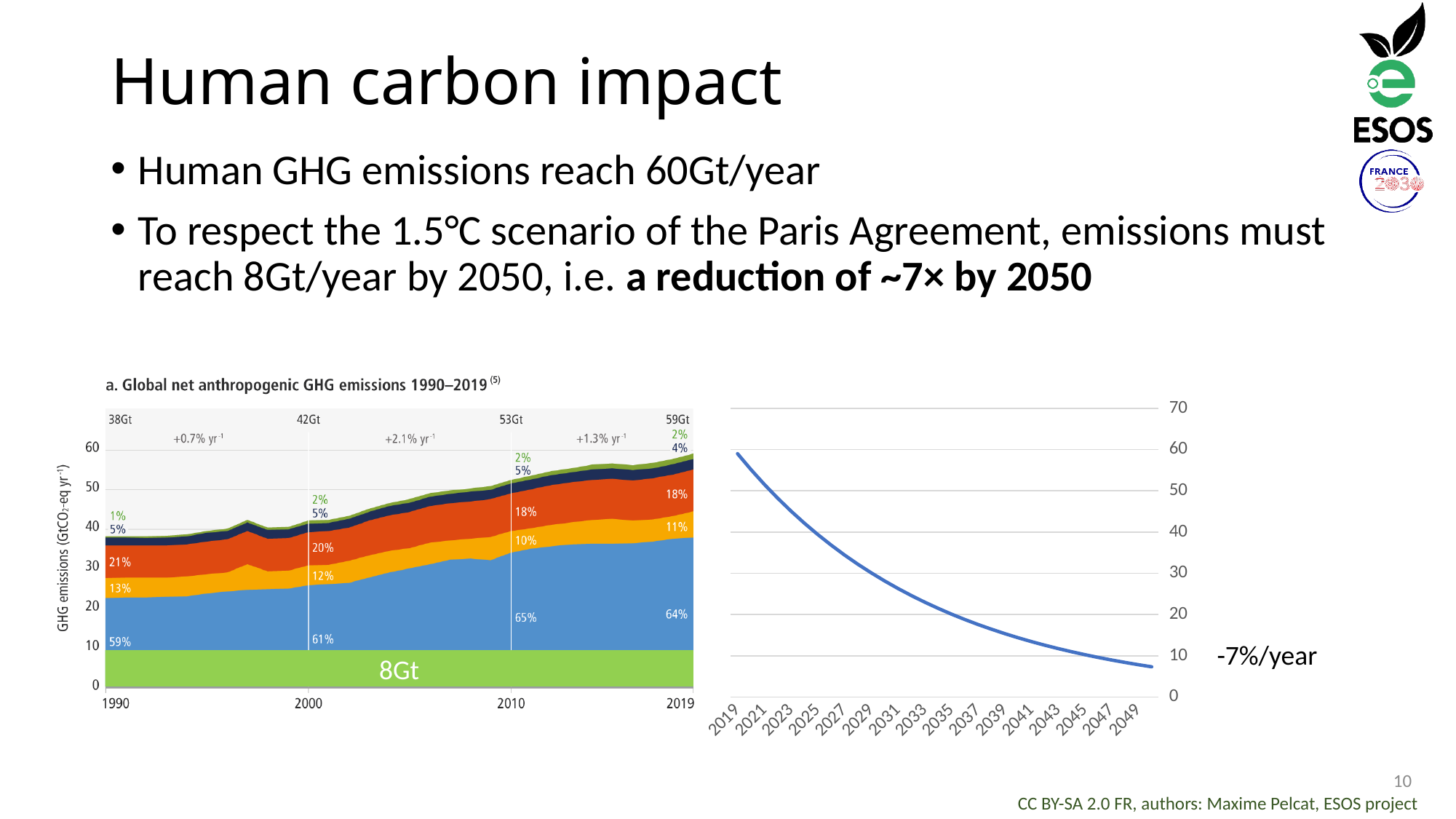
On the left chart, what was the total global net anthropogenic GHG emissions in 2019? 59Gt On the right chart, what annual rate of change is annotated next to the line? -7%/year On the left chart, what emissions level is marked by the green band at the bottom? 8Gt On the right chart, do the values rise or fall from 2019 to 2049? Fall On the left chart, by how much did total GHG emissions increase between 1990 and 2019? 21Gt On the left chart, what was the total global net anthropogenic GHG emissions in 2010? 53Gt On the left chart, what annual growth rate is shown for the period between 2000 and 2010? +2.1% yr⁻¹ On the left chart, what share of emissions did the orange (second from bottom) category represent in 2000? 12% What kind of chart is the chart on the right of the slide? Line chart On the left chart, what was the total global net anthropogenic GHG emissions in 1990? 38Gt On the left chart, which of the four labelled years has the highest total emissions? 2019 On the left chart, what share of emissions did the blue (bottom) category represent in 2019? 64%